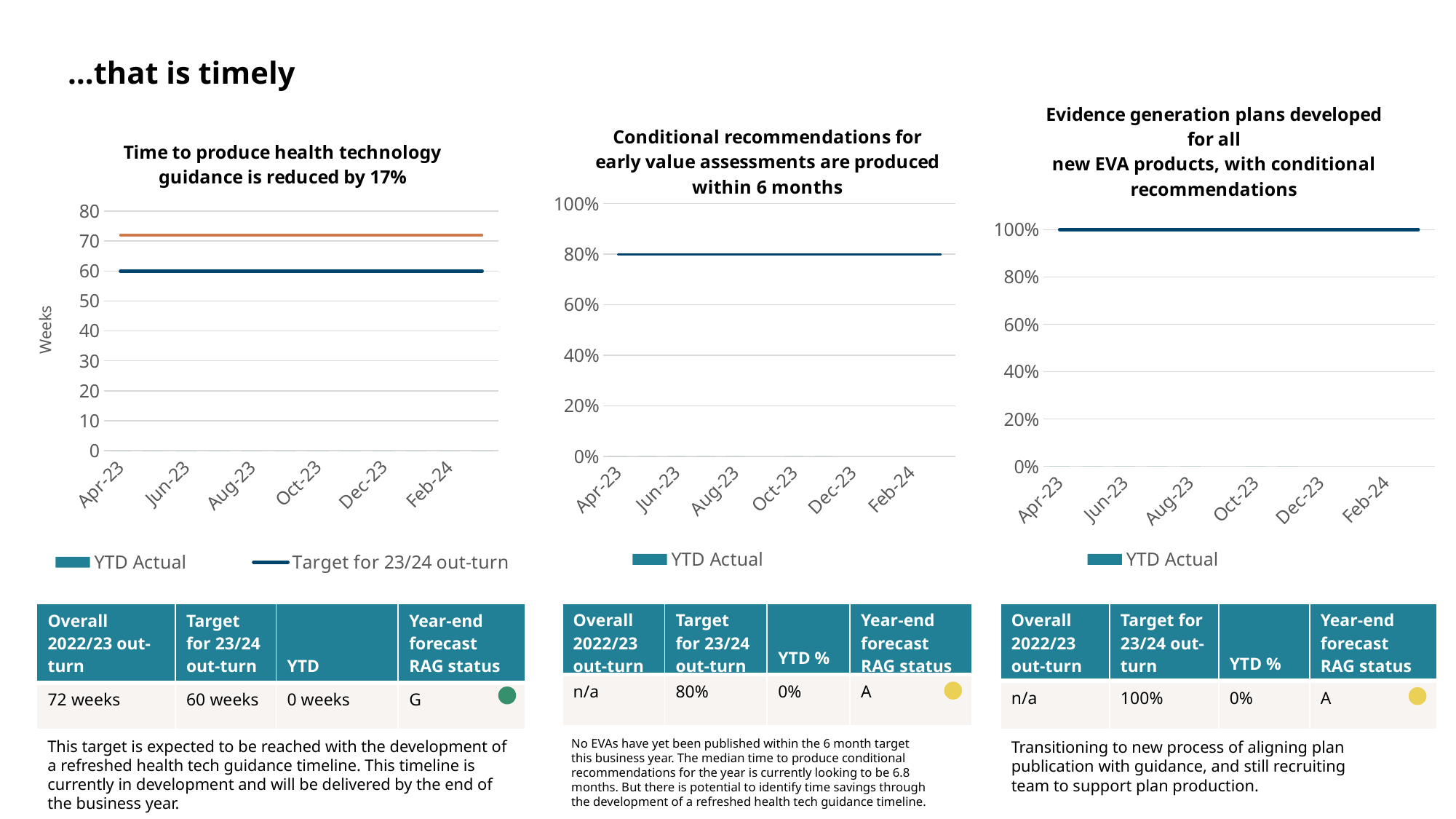
In the left chart 'Time to produce health technology guidance is reduced by 17%', what value does the 'Target for 23/24 out-turn' line sit at on the Weeks axis? 60 In the middle chart 'Conditional recommendations for early value assessments are produced within 6 months', what value does the plotted line sit at? 80% How many month labels are shown on the x axis of the right chart 'Evidence generation plans developed for all new EVA products, with conditional recommendations'? 6 What is the legend entry shown under the right chart 'Evidence generation plans developed for all new EVA products, with conditional recommendations'? YTD Actual In the right chart 'Evidence generation plans developed for all new EVA products, with conditional recommendations', what value does the plotted line sit at? 100% In the left chart 'Time to produce health technology guidance is reduced by 17%', which line is higher: the orange line or the dark blue 'Target for 23/24 out-turn' line? The orange line In the middle chart 'Conditional recommendations for early value assessments are produced within 6 months', does the line rise, fall or stay flat from Apr-23 to Feb-24? Stays flat What is the y-axis label of the left chart 'Time to produce health technology guidance is reduced by 17%'? Weeks What kind of chart is the left chart titled 'Time to produce health technology guidance is reduced by 17%'? Line chart In the left chart 'Time to produce health technology guidance is reduced by 17%', is the orange line greater or less than 70 weeks? greater How many series does the legend of the left chart 'Time to produce health technology guidance is reduced by 17%' list? 2 How many series does the legend of the middle chart 'Conditional recommendations for early value assessments are produced within 6 months' list? 1